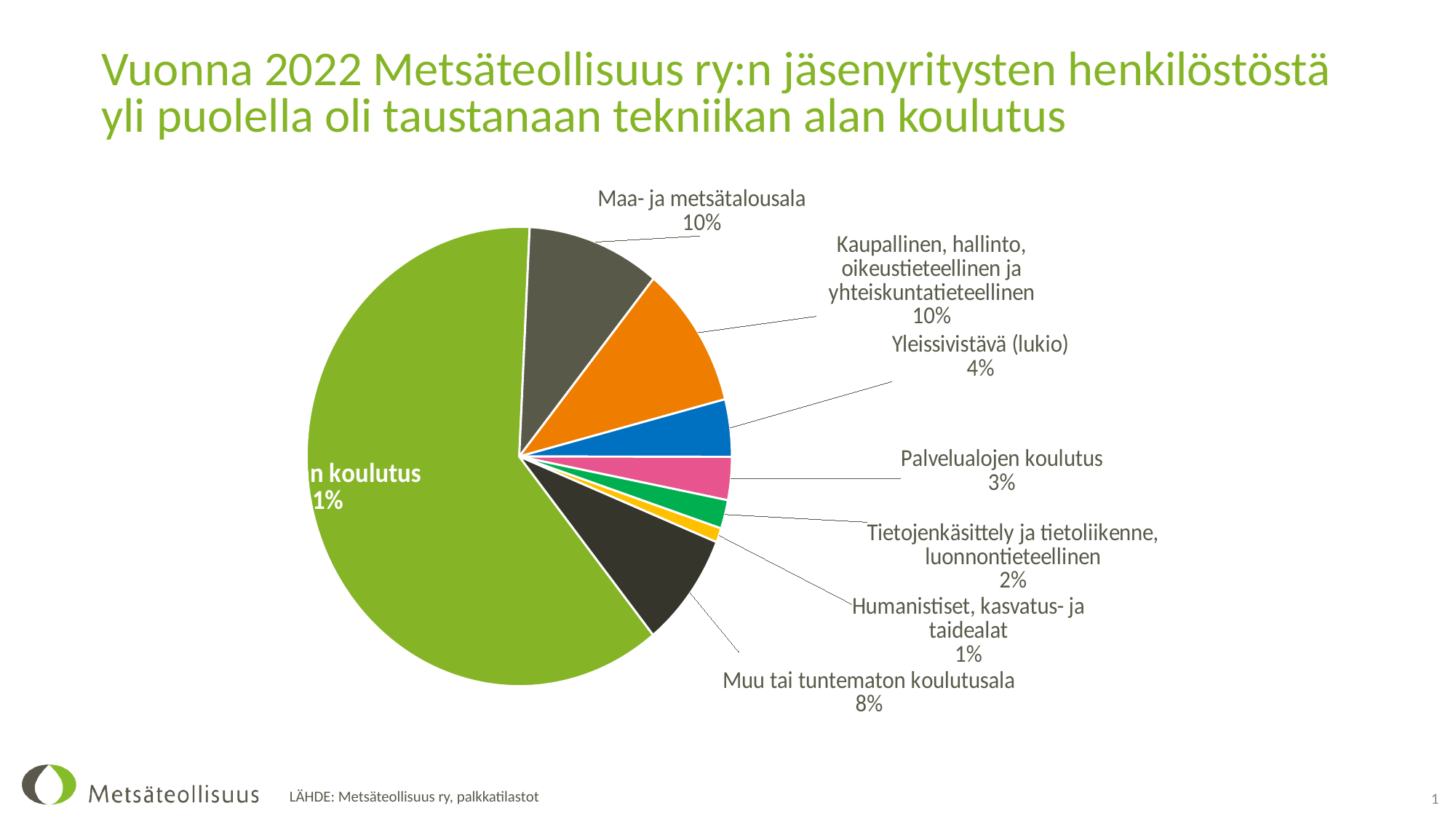
What is the value shown for Muu tai tuntematon koulutusala? 8% How many slices does the pie chart have? 8 What share of the pie does Maa- ja metsätalousala have? 10% Which category has the smallest slice in the pie chart? Humanistiset, kasvatus- ja taidealat What source is cited for the chart at the bottom of the slide? Metsäteollisuus ry, palkkatilastot What is the value shown for Yleissivistävä (lukio)? 4% What is the value shown for Kaupallinen, hallinto, oikeustieteellinen ja yhteiskuntatieteellinen? 10% What is the value shown for Tietojenkäsittely ja tietoliikenne, luonnontieteellinen? 2% What kind of chart is shown on the slide? pie chart What is the difference in percentage points between Maa- ja metsätalousala and Muu tai tuntematon koulutusala? 2 percentage points What is the value shown for Palvelualojen koulutus? 3% Which is larger: Yleissivistävä (lukio) or Palvelualojen koulutus? Yleissivistävä (lukio)